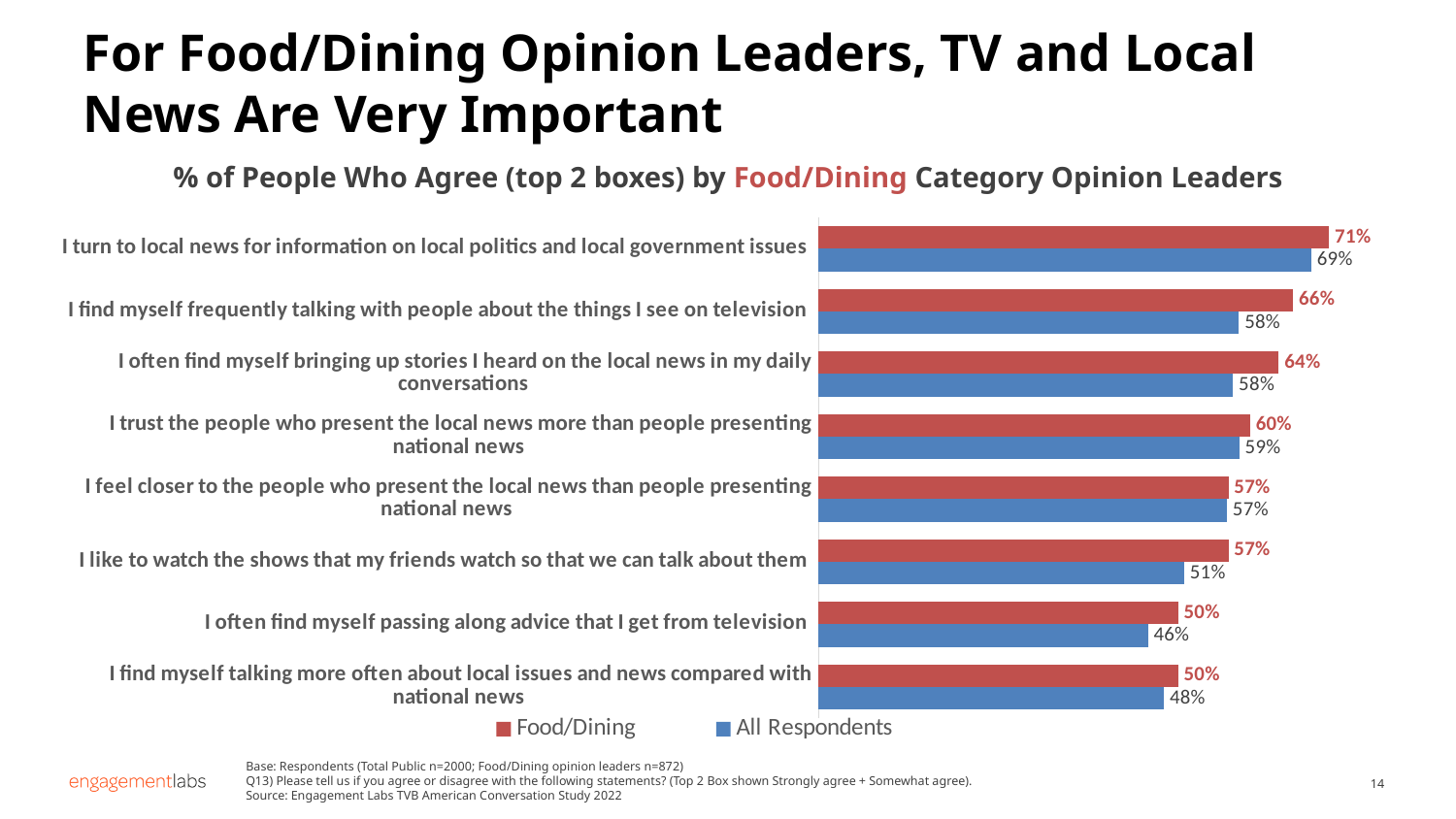
What is the difference between the Food/Dining and All Respondents values for "I often find myself bringing up stories I heard on the local news in my daily conversations"? 6 percentage points Which is larger for "I like to watch the shows that my friends watch so that we can talk about them": the Food/Dining value or the All Respondents value? Food/Dining What kind of chart is shown on the slide? Bar chart What is the difference between the Food/Dining and All Respondents values for "I find myself frequently talking with people about the things I see on television"? 8 percentage points How many statements are shown in the chart? 8 Which statement has the highest Food/Dining value? I turn to local news for information on local politics and local government issues What colour represents the Food/Dining series in the chart? Red How many series does the legend list? 2 What percentage of Food/Dining opinion leaders agree with "I turn to local news for information on local politics and local government issues"? 71% What percentage of All Respondents agree with "I find myself frequently talking with people about the things I see on television"? 58% Which statement has the lowest All Respondents value? I often find myself passing along advice that I get from television What is the All Respondents value for "I find myself talking more often about local issues and news compared with national news"? 48%